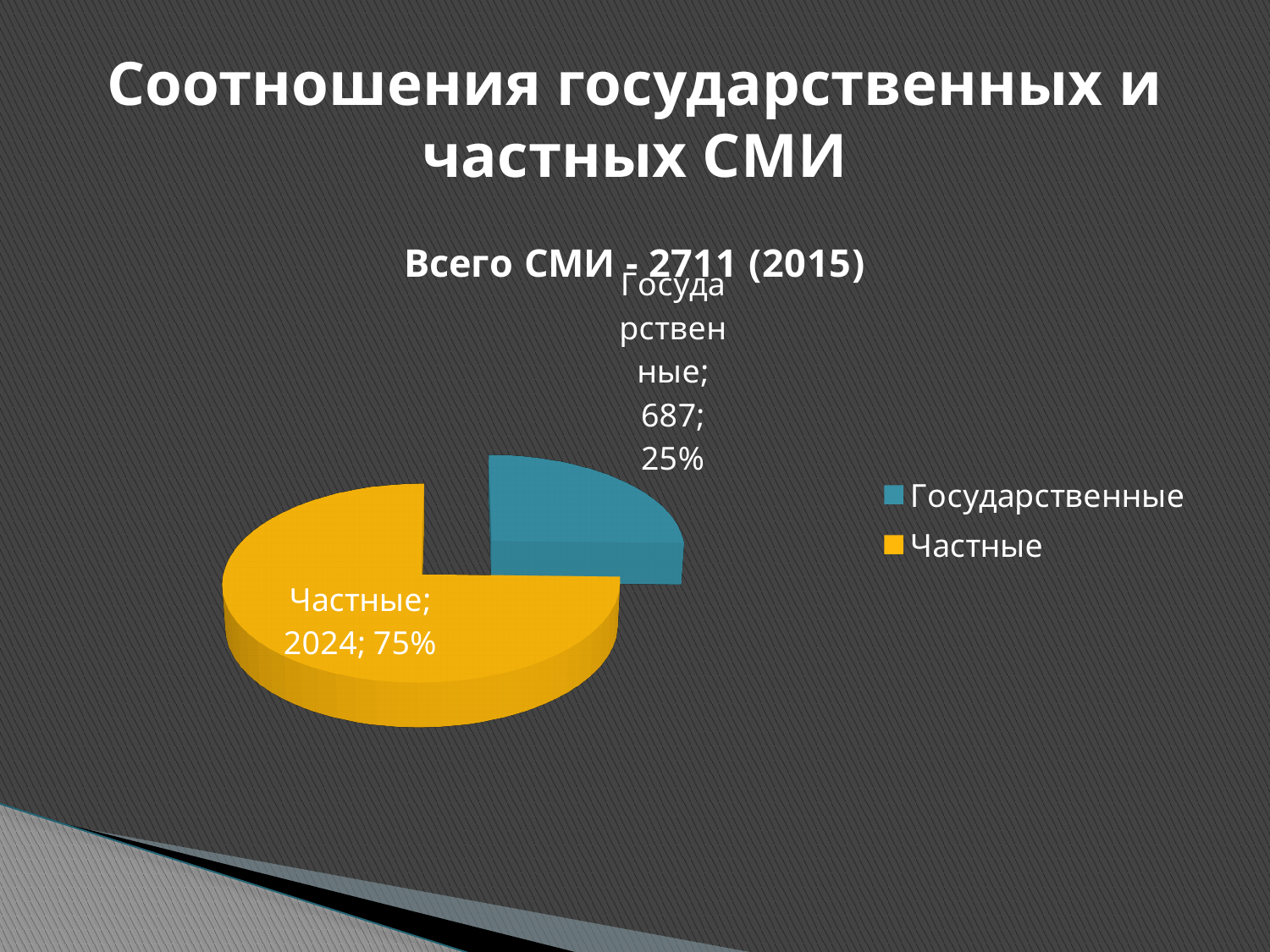
What is the value for Частные? 2024 Which is larger, Государственные or Частные? Частные What colour is the Частные slice? yellow What share of the pie does Государственные take? 25% What kind of chart is shown on the slide? pie chart Which category has the smallest slice? Государственные What share of the pie does Частные take? 75% What is the title of the chart? Всего СМИ - 2711 (2015) What is the difference between the values for Частные and Государственные? 1337 How many slices does the pie chart have? 2 Which category has the largest slice? Частные What is the value for Государственные? 687